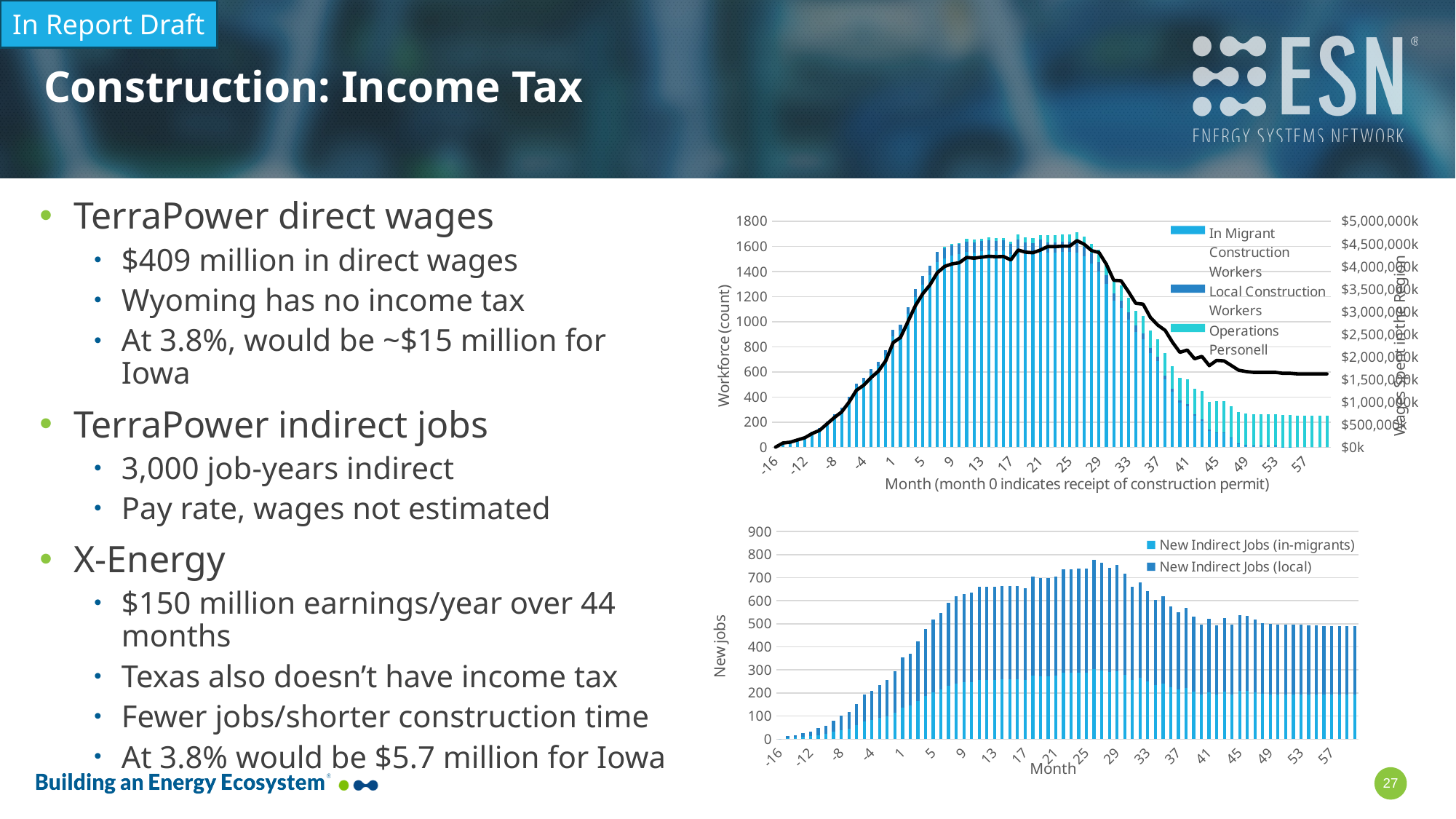
What kind of chart is the bottom chart on the slide? bar chart In the bottom chart, do the total new jobs values rise or fall from month -16 to month 25? rise In the bottom chart, is the total new jobs value at month 25 greater or less than 700? greater How many series does the legend of the top chart list? 3 In the bottom chart, is the total new jobs value at month 57 greater or less than 600? less In the top chart, is the total workforce at month 57 greater or less than 400? less What kind of chart is the top chart on the slide? combination bar and line chart In the bottom chart, what is the title of the vertical axis? New jobs How many series does the legend of the bottom chart list? 2 In the top chart, what is the title of the left vertical axis? Workforce (count) In the top chart, do the total workforce values rise or fall from month 29 to month 57? fall